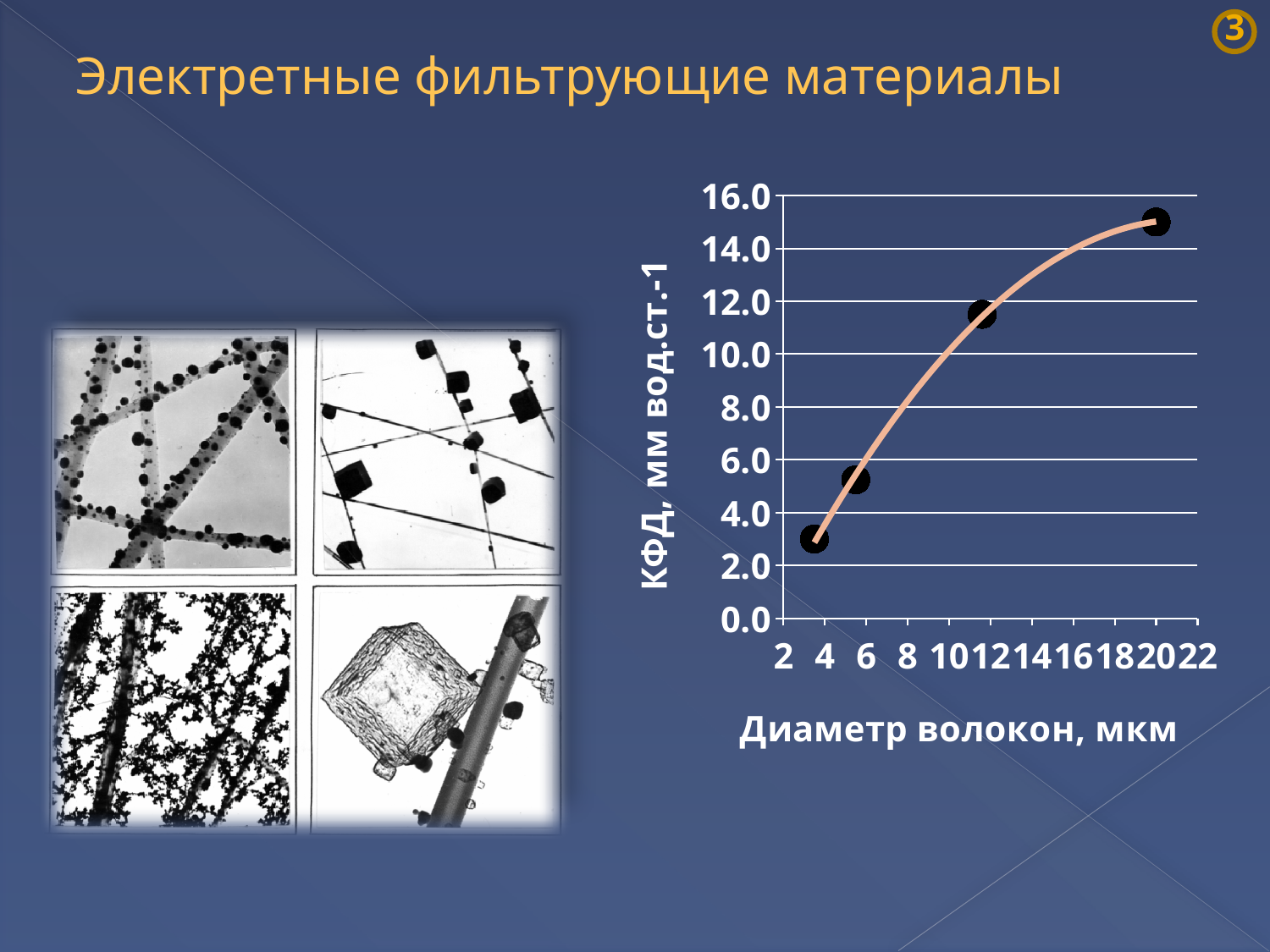
Do the plotted values rise or fall as the fibre diameter increases along the x axis? Rise Is the value of the data point near 12 мкм greater or less than 10.0? greater Is the value of the rightmost data point (near 20 мкм) greater or less than 14.0? greater What is the title of the x axis of the chart? Диаметр волокон, мкм What is the title of the y axis of the chart? КФД, мм вод.ст.-1 Which data point has the highest КФД value: the one at the smallest fibre diameter or the one at the largest fibre diameter? The one at the largest fibre diameter Which data point has the lowest КФД value: the one at the smallest fibre diameter or the one at the largest fibre diameter? The one at the smallest fibre diameter Is the value of the leftmost data point (near 4 мкм) greater or less than 4.0? less What kind of chart is shown on the slide? Scatter chart with a smoothed line How many data points are plotted on the chart? 4